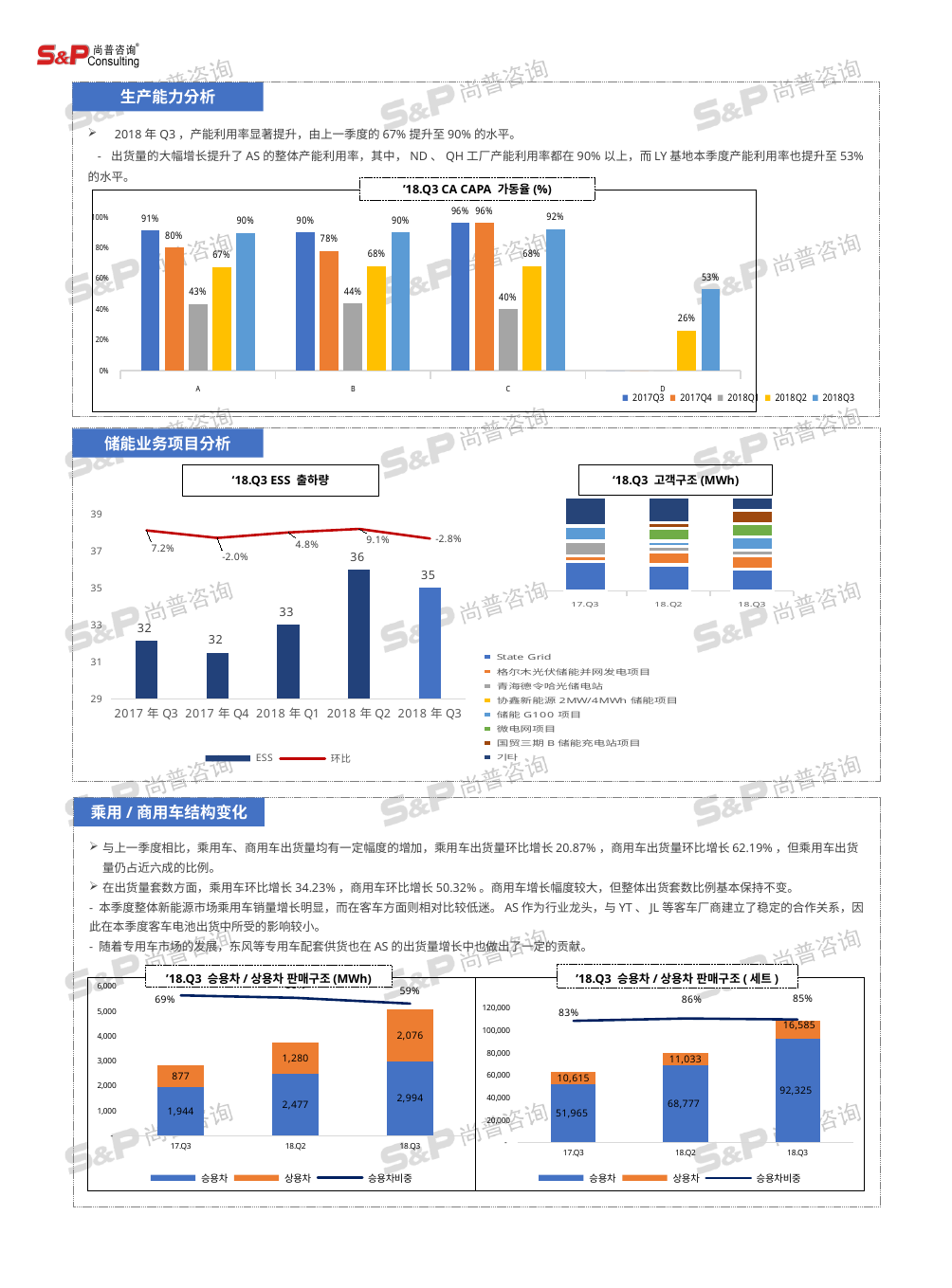
In the '18.Q3 CA CAPA 가동율 (%) chart, what is the value for 2018Q2 in category D? 26% In the '18.Q3 ESS 출하량 chart, what is the 환비 value for 2018 年 Q3? -2.8% In the '18.Q3 CA CAPA 가동율 (%) chart, which series has the lowest value in category A? 2018Q1 In the '18.Q3 승용차 / 상용차 판매구조 (세트) chart, what is the 승용차비중 value for 17.Q3? 83% In the '18.Q3 승용차 / 상용차 판매구조 (MWh) chart, what is the 상용차 value for 18.Q2? 1,280 In the '18.Q3 ESS 출하량 chart, which quarter has the highest ESS value? 2018 年 Q2 In the '18.Q3 ESS 출하량 chart, what is the ESS value for 2018 年 Q2? 36 In the '18.Q3 고객구조 (MWh) chart, how many entries does the legend list? 8 In the '18.Q3 승용차 / 상용차 판매구조 (세트) chart, what is the difference between the 승용차 values for 18.Q3 and 18.Q2? 23,548 In the '18.Q3 승용차 / 상용차 판매구조 (MWh) chart, what is the total of the stacked bar for 18.Q3? 5,070 In the '18.Q3 CA CAPA 가동율 (%) chart, what is the value for 2018Q3 in category C? 92% In the '18.Q3 CA CAPA 가동율 (%) chart, how many series does the legend list? 5